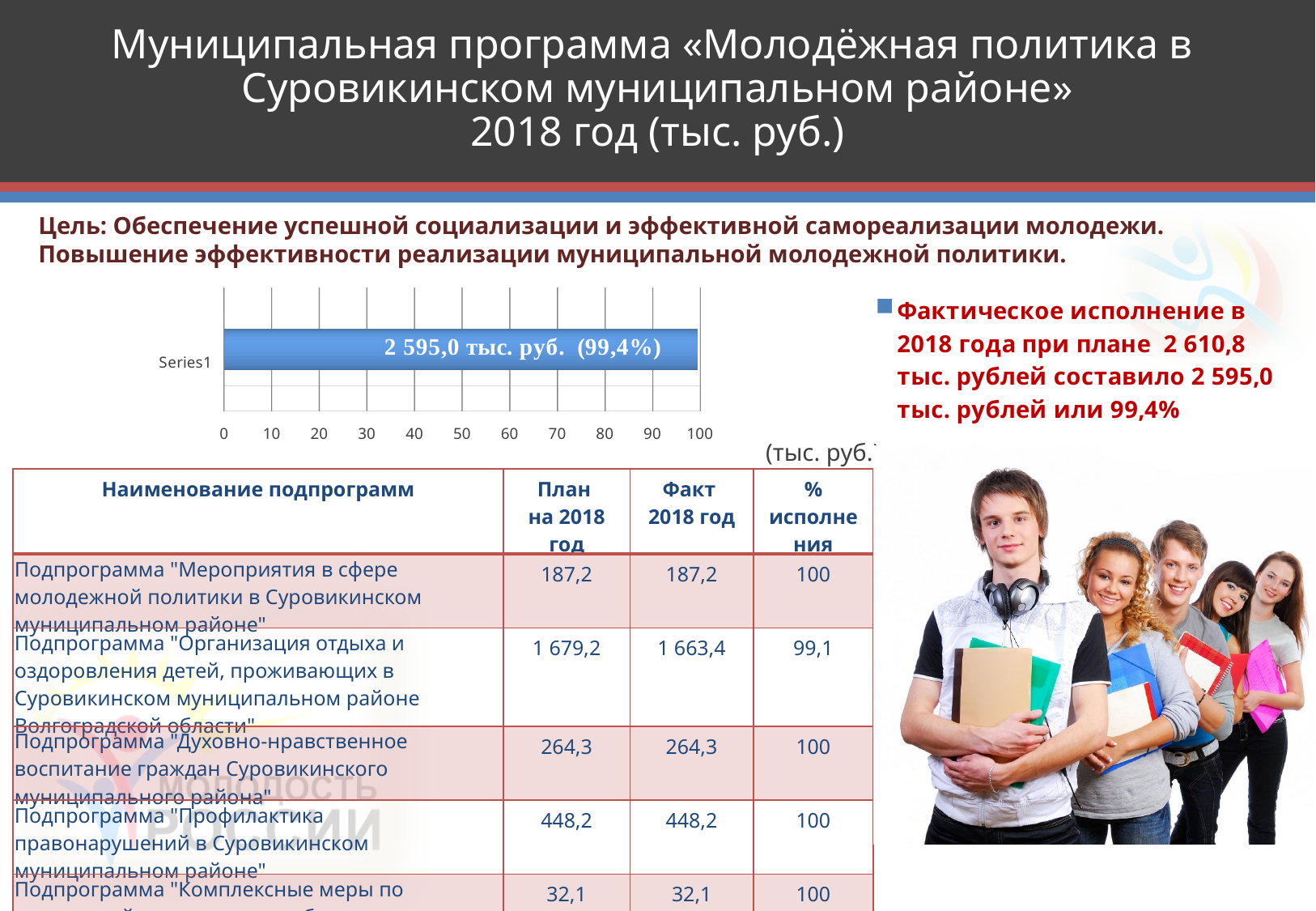
What is the category label shown on the vertical axis of the chart? Series1 How many bars does the chart show? 1 Is the value for Series1 on the chart's axis greater or less than 50? greater What is the data label printed on the bar in the chart? 2 595,0 тыс. руб. (99,4%) What percentage is shown in the data label on the bar? 99,4% Is the value for Series1 on the chart's axis greater or less than 90? greater What amount in thousand rubles is shown in the data label on the bar? 2 595,0 тыс. руб. What is the maximum value shown on the chart's horizontal axis? 100 What kind of chart is shown on the slide? bar chart